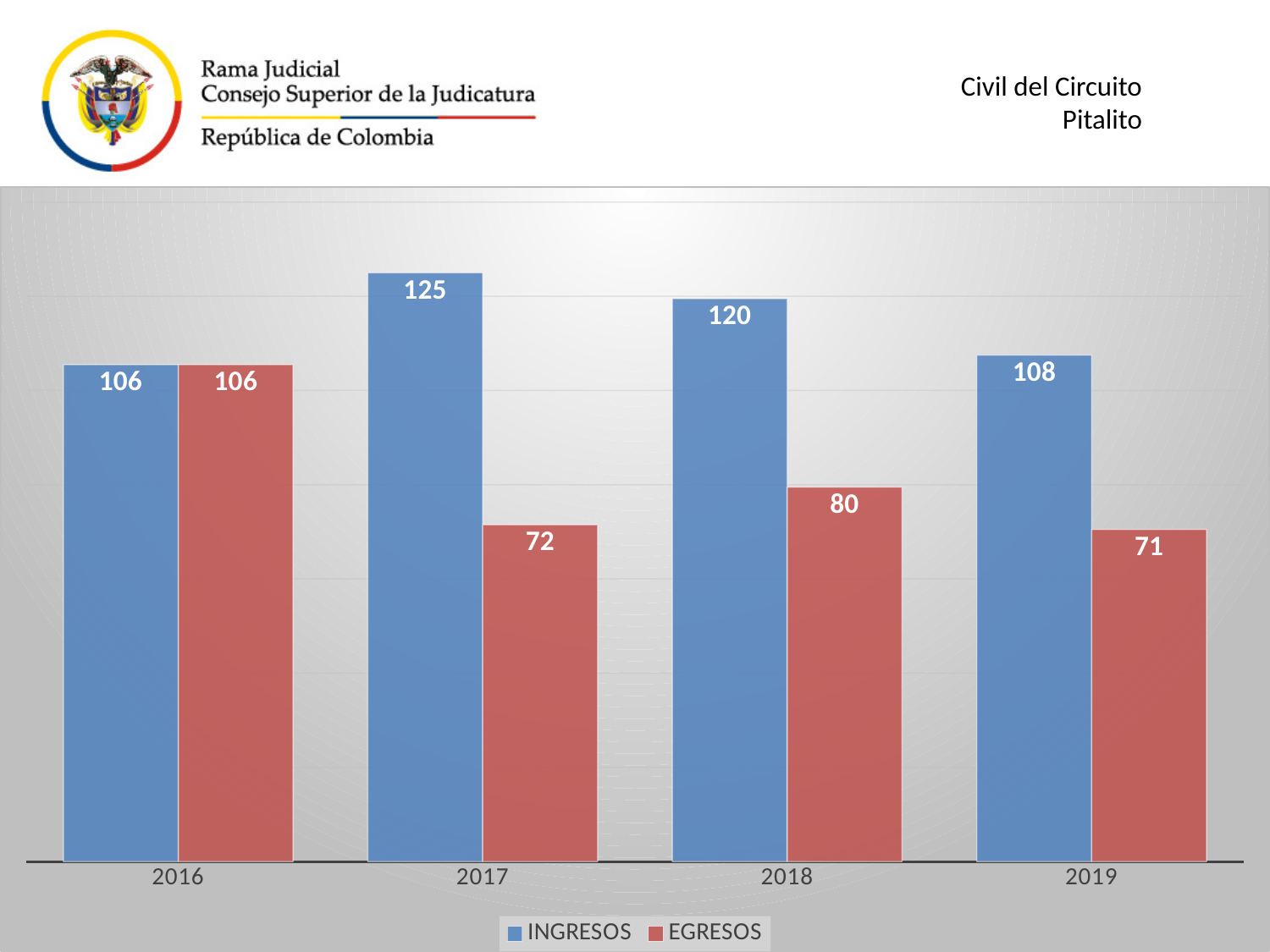
What is the difference between INGRESOS and EGRESOS in 2018? 40 What kind of chart is shown on the slide? bar chart What is the EGRESOS value for 2019? 71 What is the EGRESOS value for 2016? 106 Which year has the highest INGRESOS value? 2017 How many series does the legend list? 2 Which year has the lowest EGRESOS value? 2019 Which series is shown in red in the legend? EGRESOS Which is larger, EGRESOS in 2017 or EGRESOS in 2018? EGRESOS in 2018 What is the INGRESOS value for 2017? 125 How many years are shown on the x axis? 4 What is the difference between INGRESOS in 2017 and INGRESOS in 2019? 17